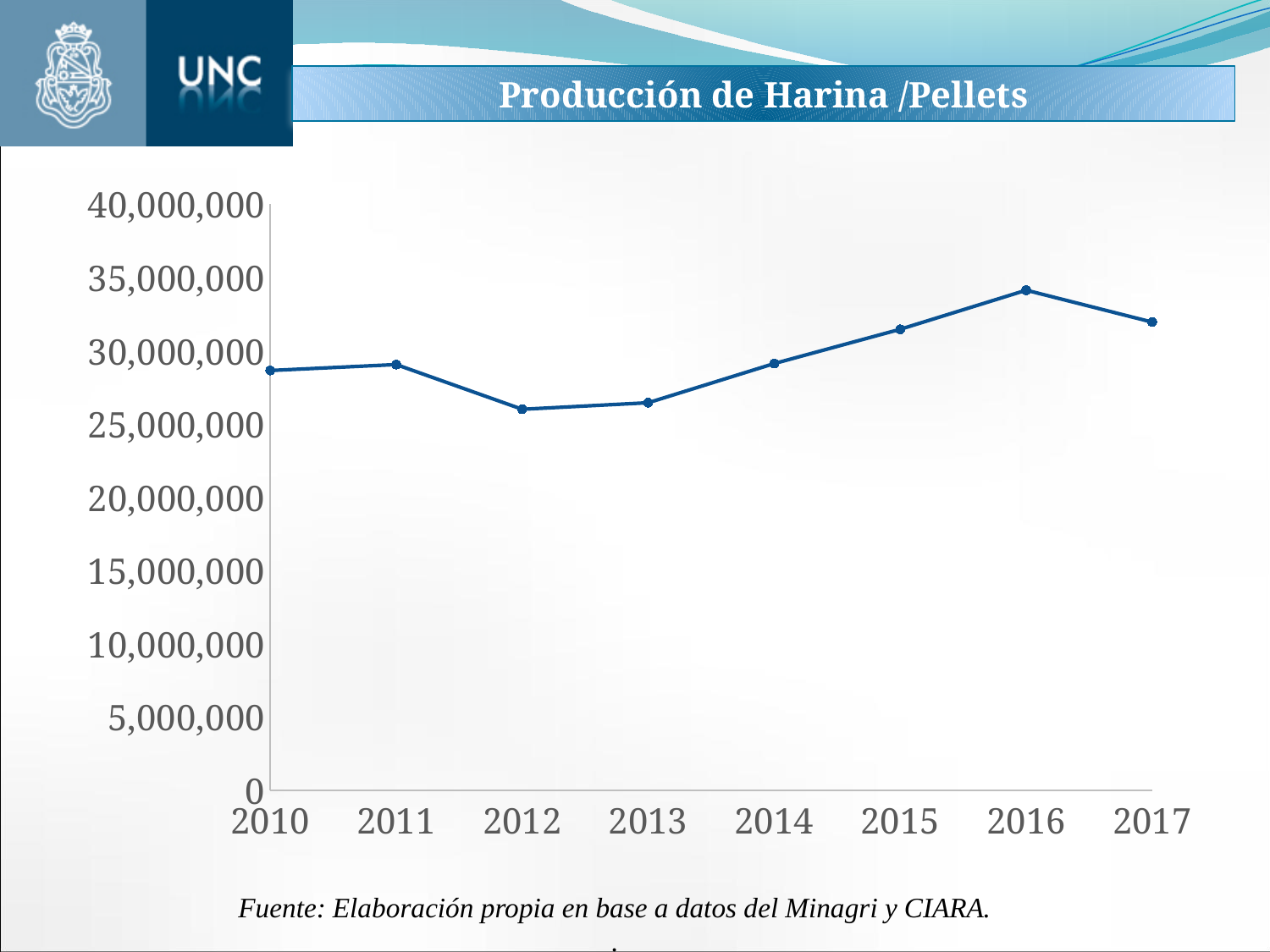
Which year has the highest production value? 2016 Which is larger, the value for 2016 or the value for 2012? 2016 Is the value for 2010 greater or less than 30,000,000? less What is the title of the chart? Producción de Harina /Pellets Which is larger, the value for 2013 or the value for 2015? 2015 Is the value for 2016 greater or less than 30,000,000? greater What kind of chart is shown on the slide? line chart Is the value for 2013 greater or less than 25,000,000? greater Do the values rise or fall from 2013 to 2016? rise How many years are plotted on the x axis? 8